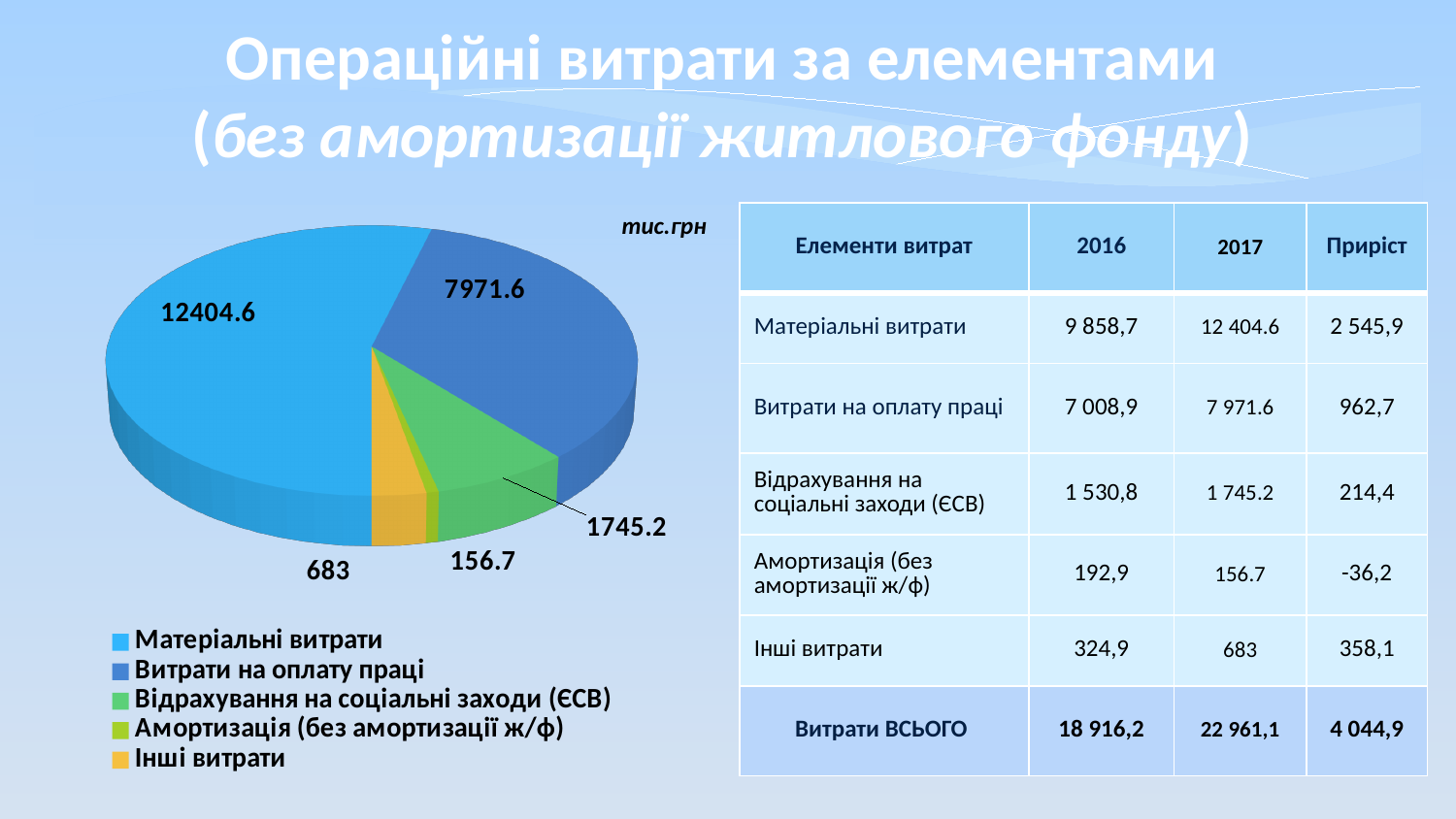
Which category has the smallest slice in the pie chart? Амортизація (без амортизації ж/ф) What is the value of the Матеріальні витрати slice in the pie chart? 12404.6 Which is larger in the pie chart: Відрахування на соціальні заходи (ЄСВ) or Інші витрати? Відрахування на соціальні заходи (ЄСВ) What is the value of the Витрати на оплату праці slice in the pie chart? 7971.6 What is the value of the Відрахування на соціальні заходи (ЄСВ) slice in the pie chart? 1745.2 Which category has the largest slice in the pie chart? Матеріальні витрати How many slices does the pie chart have? 5 What is the value of the Інші витрати slice in the pie chart? 683 What unit is indicated next to the pie chart? тис.грн What is the difference between the Інші витрати and Амортизація (без амортизації ж/ф) values in the pie chart? 526.3 What type of chart is shown on the slide? Pie chart What is the difference between the Матеріальні витрати and Витрати на оплату праці values in the pie chart? 4433.0